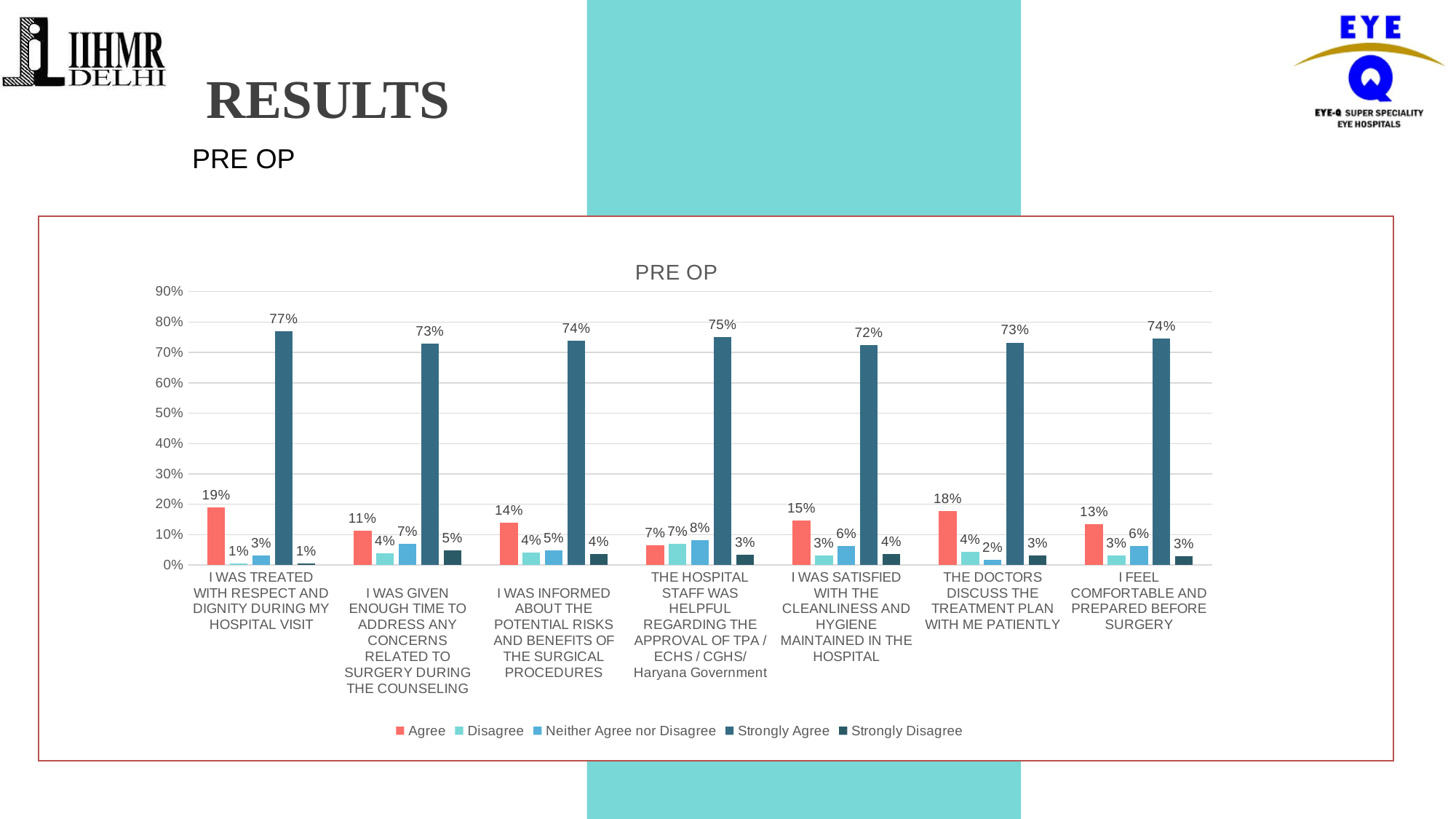
What is the Neither Agree nor Disagree value for "THE HOSPITAL STAFF WAS HELPFUL REGARDING THE APPROVAL OF TPA / ECHS / CGHS/ Haryana Government"? 8% How many series does the legend list? 5 How many statement categories are shown on the x axis? 7 What is the difference between the Strongly Agree values for "I WAS TREATED WITH RESPECT AND DIGNITY DURING MY HOSPITAL VISIT" and "I WAS SATISFIED WITH THE CLEANLINESS AND HYGIENE MAINTAINED IN THE HOSPITAL"? 5% What is the Agree value for "THE DOCTORS DISCUSS THE TREATMENT PLAN WITH ME PATIENTLY"? 18% Which is larger: the Agree value for "I WAS INFORMED ABOUT THE POTENTIAL RISKS AND BENEFITS OF THE SURGICAL PROCEDURES" or for "I FEEL COMFORTABLE AND PREPARED BEFORE SURGERY"? I WAS INFORMED ABOUT THE POTENTIAL RISKS AND BENEFITS OF THE SURGICAL PROCEDURES What type of chart is shown on the slide? Bar chart Which statement has the highest Strongly Agree value? I WAS TREATED WITH RESPECT AND DIGNITY DURING MY HOSPITAL VISIT What is the title of the chart? PRE OP Which statement has the lowest Agree value? THE HOSPITAL STAFF WAS HELPFUL REGARDING THE APPROVAL OF TPA / ECHS / CGHS/ Haryana Government What is the Strongly Agree value for "I WAS TREATED WITH RESPECT AND DIGNITY DURING MY HOSPITAL VISIT"? 77% Is the Strongly Agree value for "I WAS GIVEN ENOUGH TIME TO ADDRESS ANY CONCERNS RELATED TO SURGERY DURING THE COUNSELING" greater or less than 60%? greater